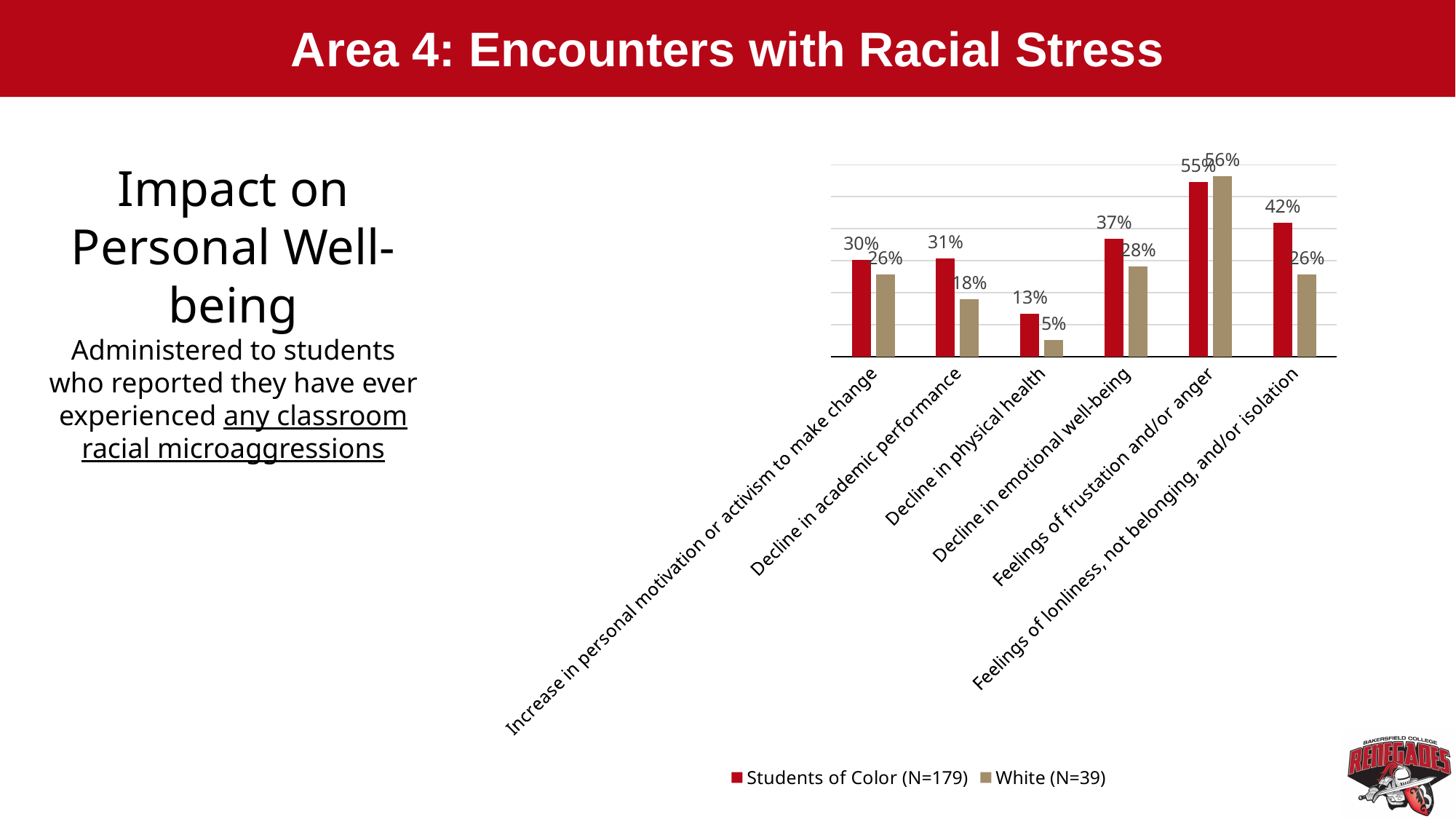
How many series does the chart legend list? 2 What is the difference between the Students of Color (N=179) and White (N=39) values for "Increase in personal motivation or activism to make change"? 4% How many categories are shown on the x axis of the chart? 6 Which category has the highest value for Students of Color (N=179)? Feelings of frustration and/or anger Which category has the lowest value for White (N=39)? Decline in physical health For "Decline in physical health", which series has the larger value: Students of Color (N=179) or White (N=39)? Students of Color (N=179) What is the value for Students of Color (N=179) for "Decline in emotional well-being"? 37% What is the sample size (N) shown in the legend for the White series? 39 What is the difference between the Students of Color (N=179) and White (N=39) values for "Feelings of lonliness, not belonging, and/or isolation"? 16% What kind of chart is shown on the slide? Bar chart What is the value for White (N=39) for "Decline in academic performance"? 18% What is the value for White (N=39) for "Feelings of frustration and/or anger"? 56%